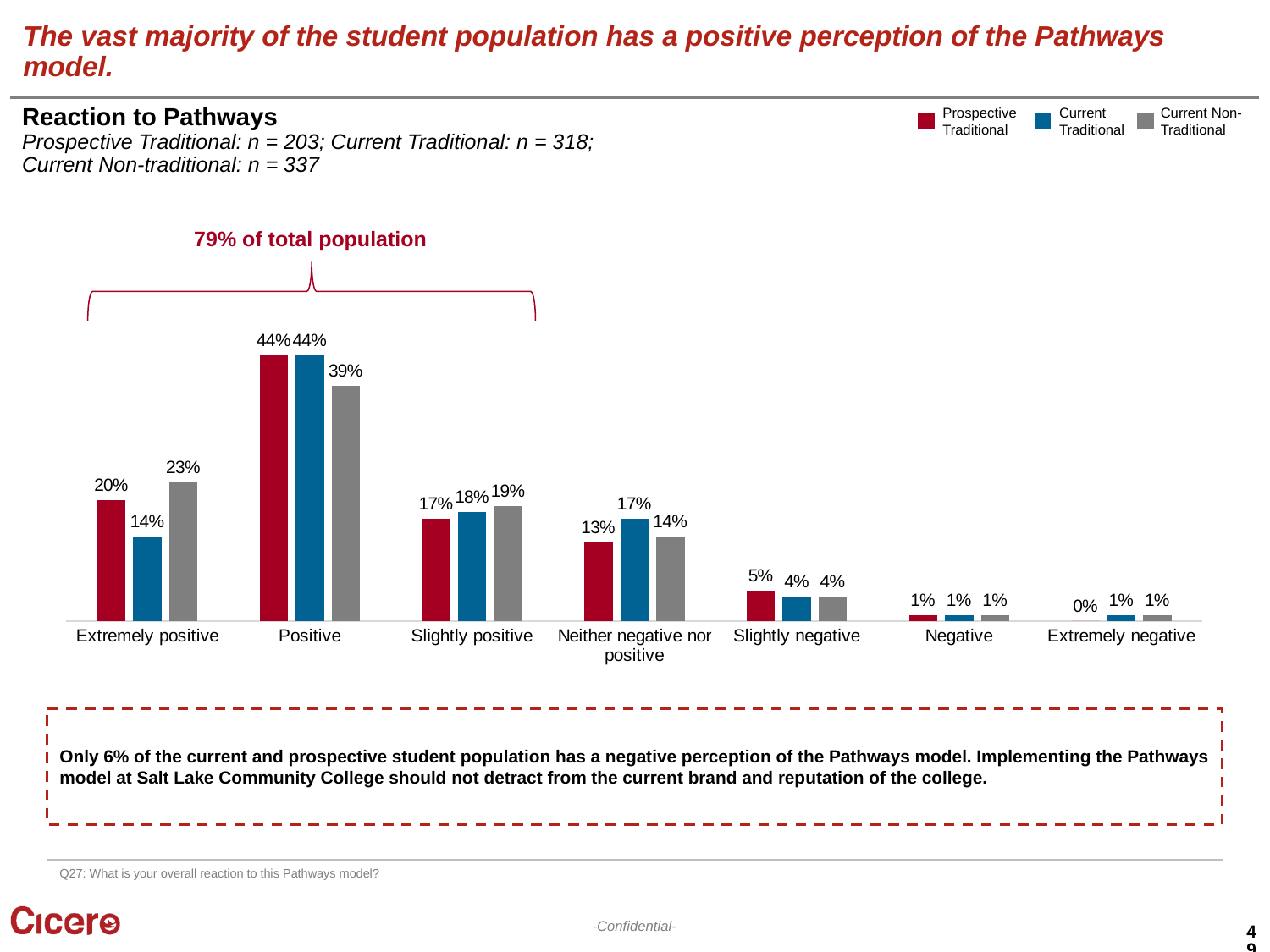
What is the value for Current Non-Traditional in the Extremely positive category? 23% What is the difference between the Prospective Traditional and Current Traditional values in the Extremely positive category? 6% What is the value for Current Traditional in the Neither negative nor positive category? 17% What is the value for Prospective Traditional in the Positive category? 44% Which category has the lowest value for Prospective Traditional? Extremely negative Which category has the highest value for Current Non-Traditional? Positive What kind of chart is shown on the slide? Bar chart What share of the total population does the bracket over the first two categories indicate? 79% of total population How many reaction categories are shown on the x axis? 7 What is the value for Prospective Traditional in the Extremely negative category? 0% How many series does the legend list? 3 Which is larger in the Positive category: Current Traditional or Current Non-Traditional? Current Traditional